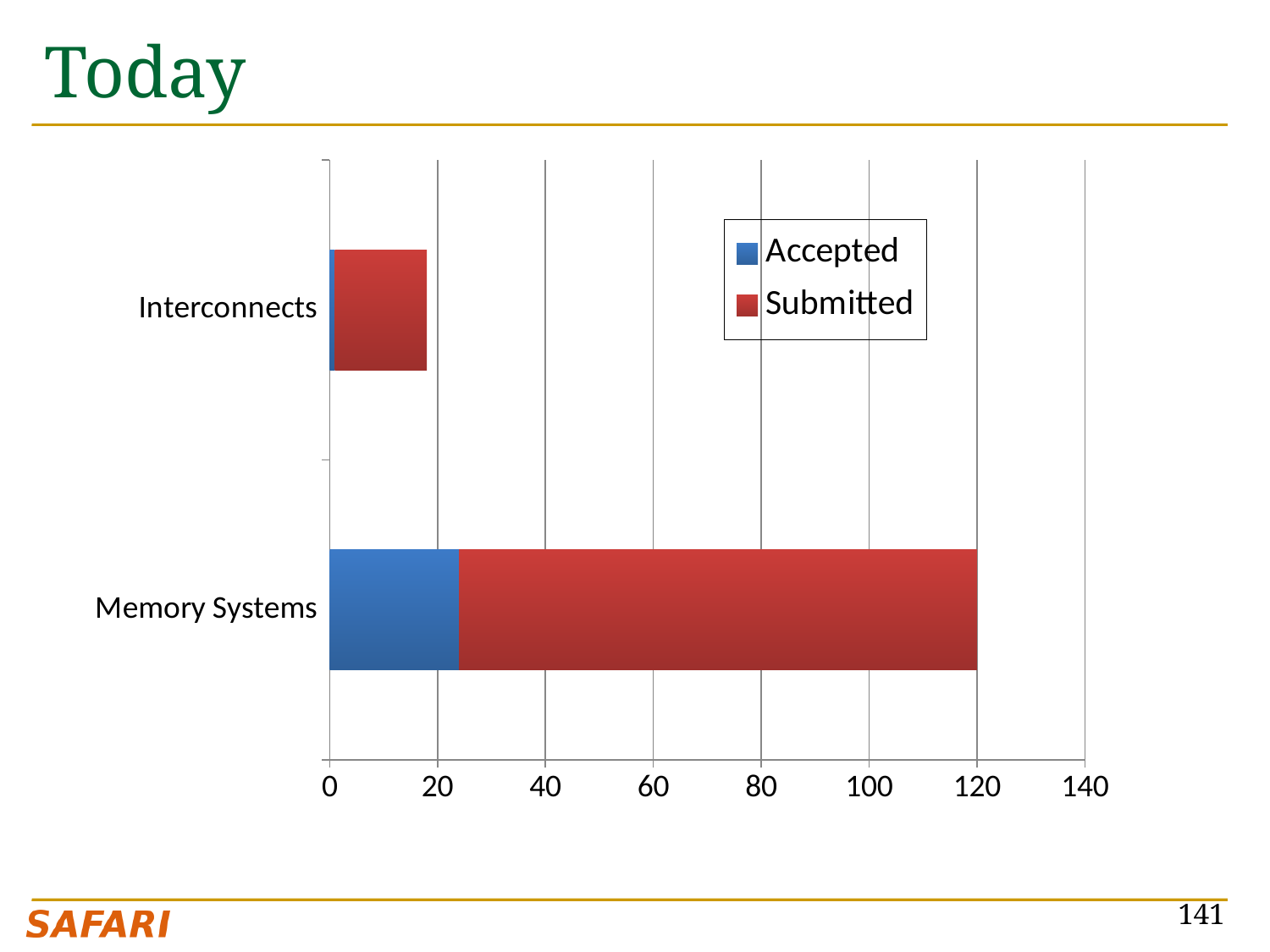
Which category has the larger Submitted value, Interconnects or Memory Systems? Memory Systems Which category has the larger Accepted value, Interconnects or Memory Systems? Memory Systems What kind of chart is shown on the slide? bar chart How many categories are shown on the chart? 2 Is the total stacked value for Memory Systems greater or less than 100? greater How many series does the legend list? 2 What is the total stacked value of the Memory Systems bar? 120 Which category has the longest total bar? Memory Systems Is the Accepted value for Memory Systems greater or less than 40? less Which series is shown in red in the legend? Submitted Is the total stacked value for Interconnects greater or less than 20? less Which category has the shortest total bar? Interconnects